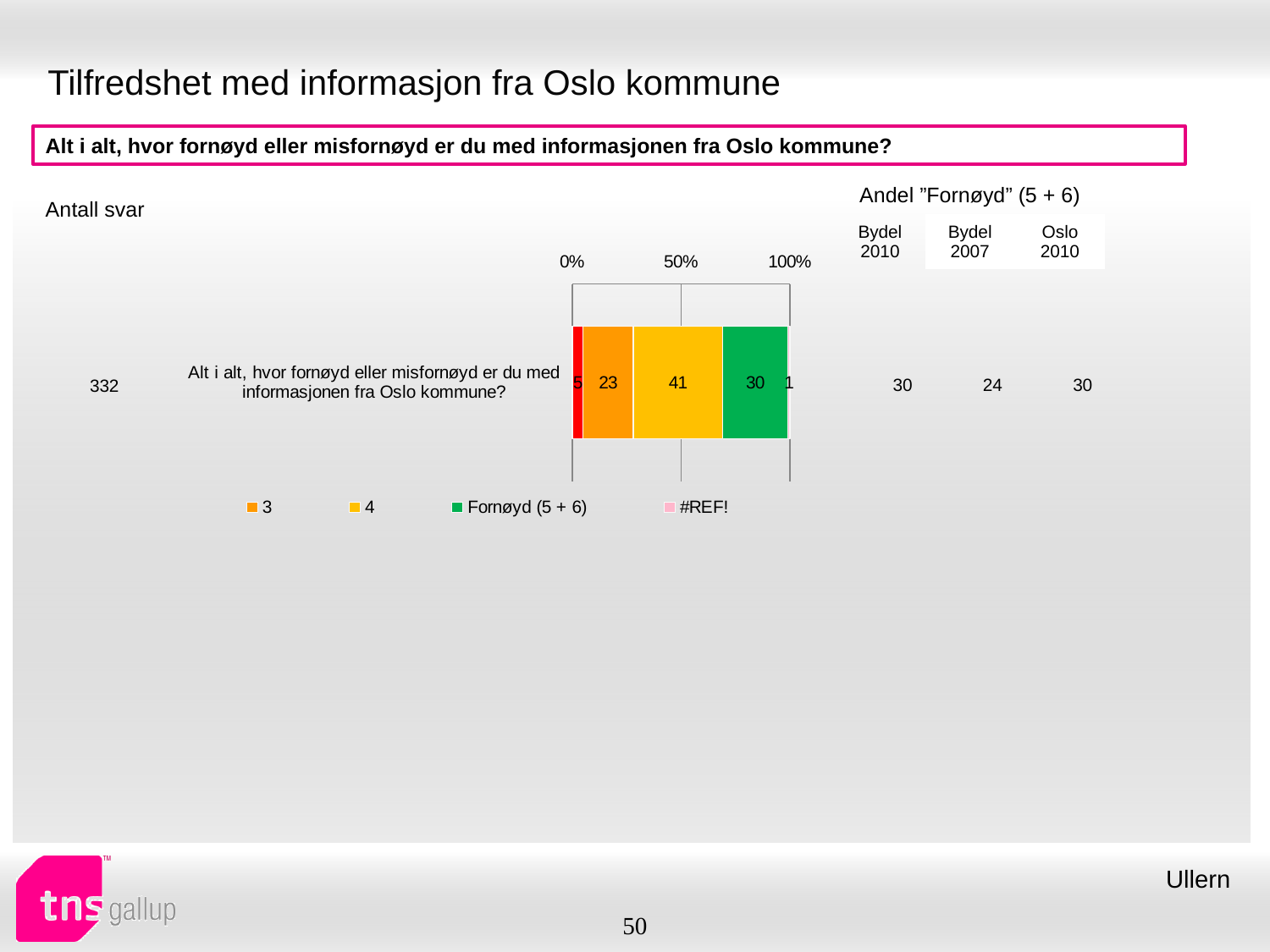
What is the last entry shown in the chart legend? #REF! What is the difference between the "4" segment and the "3" segment? 18 What is the difference between the "4" segment and the "Fornøyd (5 + 6)" segment? 11 What colour is the "4" series in the chart? Yellow Which legend category has the largest segment in the bar? 4 How many bars does the chart contain? 1 What is the value of the "3" segment in the stacked bar? 23 What is the value of the "4" segment in the stacked bar? 41 Which is larger, the "3" segment or the "Fornøyd (5 + 6)" segment? Fornøyd (5 + 6) What is the value of the "Fornøyd (5 + 6)" segment in the stacked bar? 30 What kind of chart is shown on the slide? Stacked bar chart How many entries does the chart legend list? 4